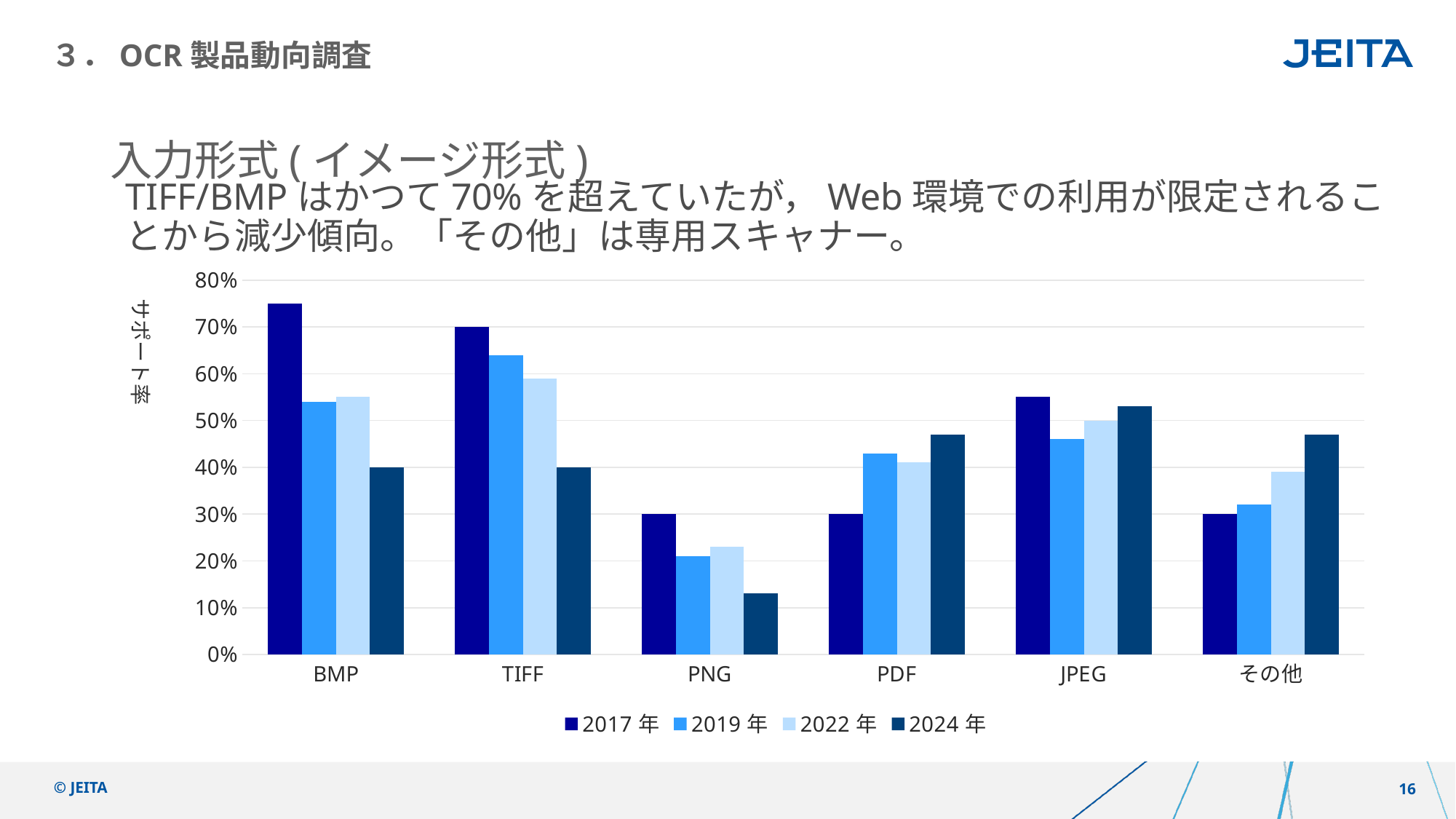
Which category has the lowest value in 2024年? PNG How many categories are shown on the x axis? 6 What is the value for JPEG in 2022年? 50% Is the value for PNG in 2024年 greater or less than 20%? less What kind of chart is shown on the slide? bar chart What is the value for BMP in 2024年? 40% Is the value for BMP in 2017年 greater or less than 70%? greater Which is larger for PDF: the 2017年 value or the 2024年 value? 2024年 What is the value for TIFF in 2017年? 70% How many series does the legend list? 4 Do the values for TIFF rise or fall from 2017年 to 2024年? fall Which category has the highest value in 2017年? BMP